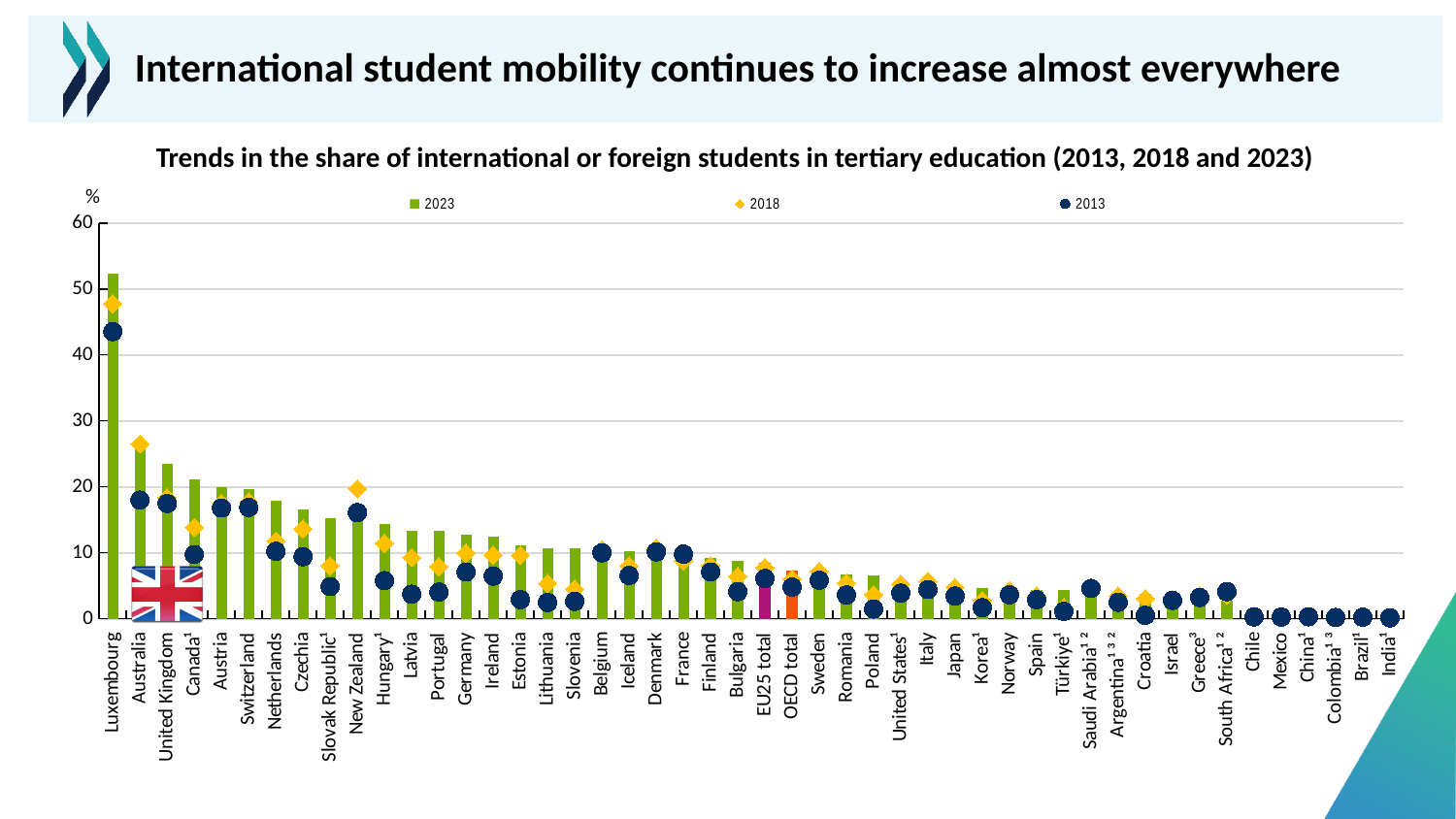
Is the 2023 value for Netherlands greater or less than 20? less What is the title of the chart? Trends in the share of international or foreign students in tertiary education (2013, 2018 and 2023) Which has the larger 2023 value, Australia or United Kingdom? Australia Is the 2023 value for Australia greater or less than 20? greater How many series does the legend list? 3 Is the 2013 value for Luxembourg greater or less than 40? greater How many categories are shown on the x axis? 48 Which country has the highest 2023 bar? Luxembourg Do the 2023 bars generally rise or fall from left to right across the x axis? Fall What kind of chart is shown on the slide? Bar chart